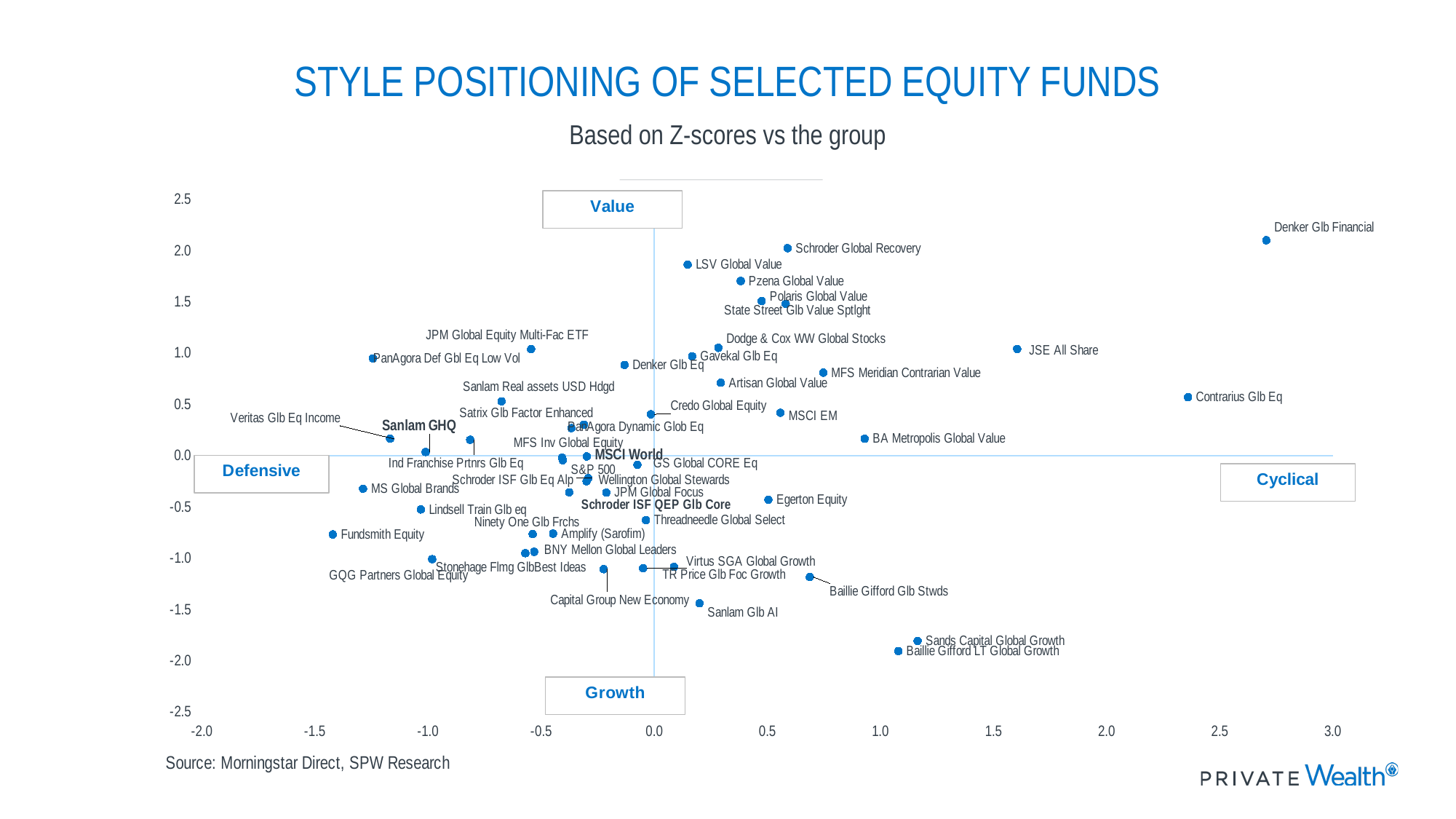
Which fund is positioned furthest to the left (lowest x-axis value)? Fundsmith Equity What kind of chart is shown on the slide? Scatter chart Is the y-axis value for Baillie Gifford LT Global Growth greater or less than -1.5? less What is the title of the chart? STYLE POSITIONING OF SELECTED EQUITY FUNDS Which fund is positioned furthest to the right (highest x-axis value)? Denker Glb Financial Is the x-axis value for Contrarius Glb Eq greater or less than 2.0? greater Is the y-axis value for Sanlam Glb AI greater or less than -1.0? less What are the four style labels placed at the ends of the axes? Value, Growth, Defensive, Cyclical Which has the higher y-axis value, Schroder Global Recovery or Sanlam Glb AI? Schroder Global Recovery